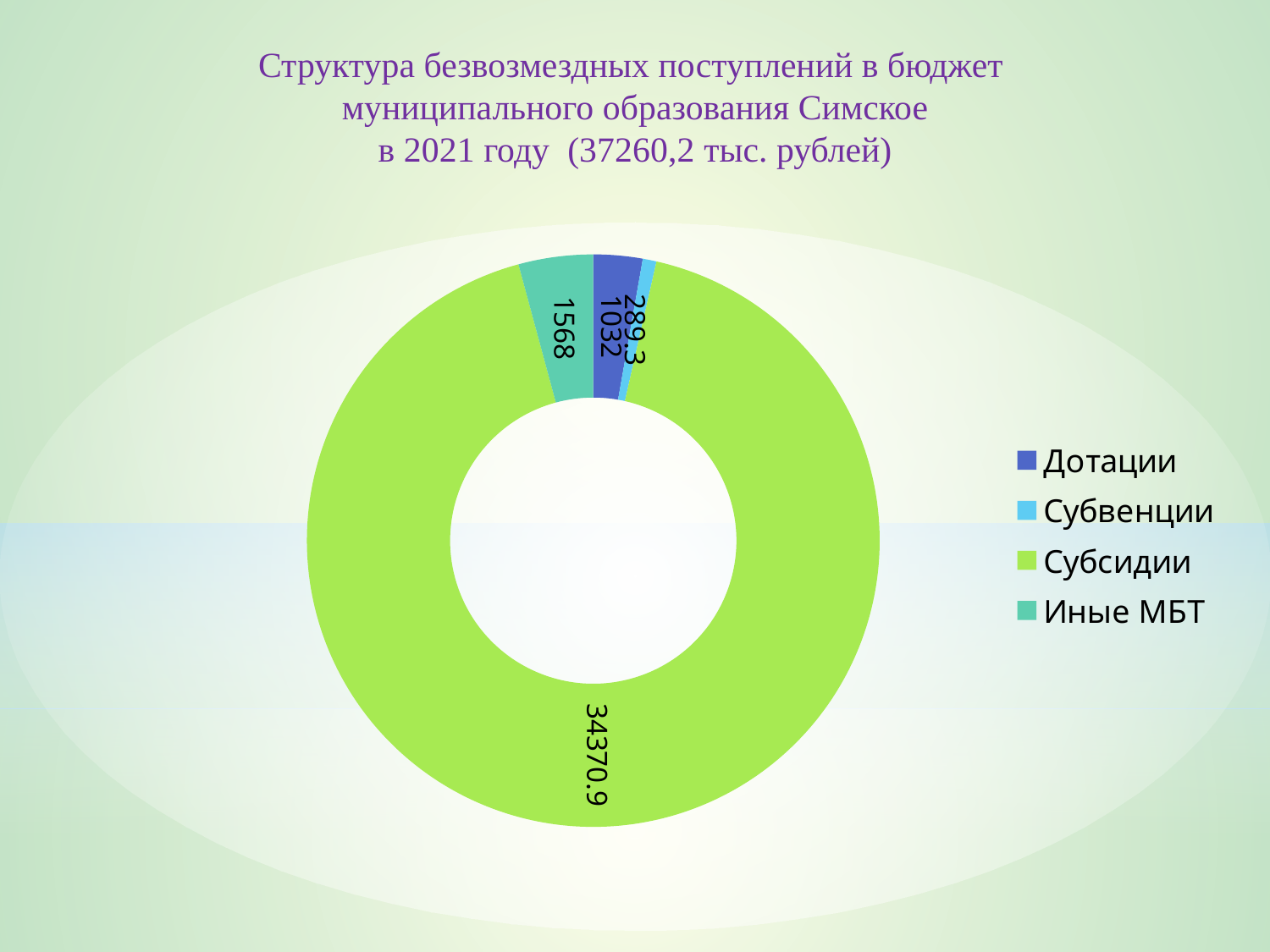
What value is shown for Субвенции on the chart? 289.3 Which category has the largest value on the chart? Субсидии Which category has the smallest value on the chart? Субвенции Which is larger, the value for Дотации or the value for Иные МБТ? Иные МБТ What value is shown for Субсидии on the chart? 34370.9 How many categories does the chart show? 4 Which colour represents Субсидии in the legend? green What is the difference between the values for Субсидии and Иные МБТ? 32802.9 What value is shown for Иные МБТ on the chart? 1568 What value is shown for Дотации on the chart? 1032 What kind of chart is shown on the slide? doughnut chart What is the difference between the values for Иные МБТ and Дотации? 536